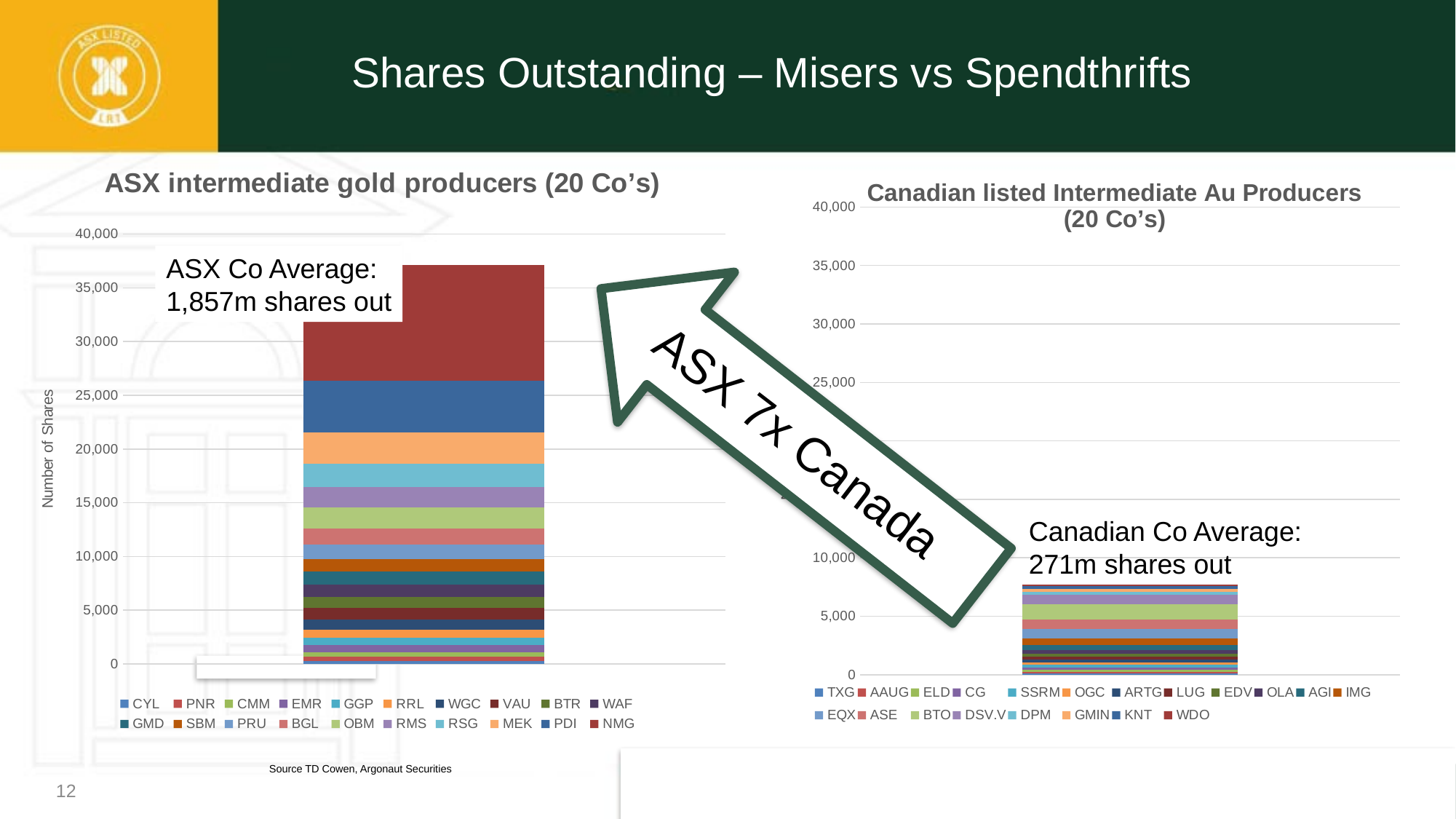
How many series does the legend of the 'ASX intermediate gold producers (20 Co's)' chart list? 20 What kind of chart is the 'ASX intermediate gold producers (20 Co's)' chart? Stacked bar chart In the 'ASX intermediate gold producers (20 Co's)' chart, is the total height of the stacked bar greater or less than 40,000? less According to the annotation on the 'ASX intermediate gold producers (20 Co's)' chart, what is the ASX Co Average shares out? 1,857m shares out In the 'Canadian listed Intermediate Au Producers (20 Co's)' chart, is the total height of the stacked bar greater or less than 5,000? greater Which chart has the taller stacked bar, the ASX intermediate gold producers chart or the Canadian listed Intermediate Au Producers chart? ASX intermediate gold producers What is the y-axis label of the 'ASX intermediate gold producers (20 Co's)' chart? Number of Shares In the 'Canadian listed Intermediate Au Producers (20 Co's)' chart, is the total height of the stacked bar greater or less than 10,000? less How many stacked bars are plotted in the 'Canadian listed Intermediate Au Producers (20 Co's)' chart? 1 How many series does the legend of the 'Canadian listed Intermediate Au Producers (20 Co's)' chart list? 20 According to the annotation on the 'Canadian listed Intermediate Au Producers (20 Co's)' chart, what is the Canadian Co Average shares out? 271m shares out